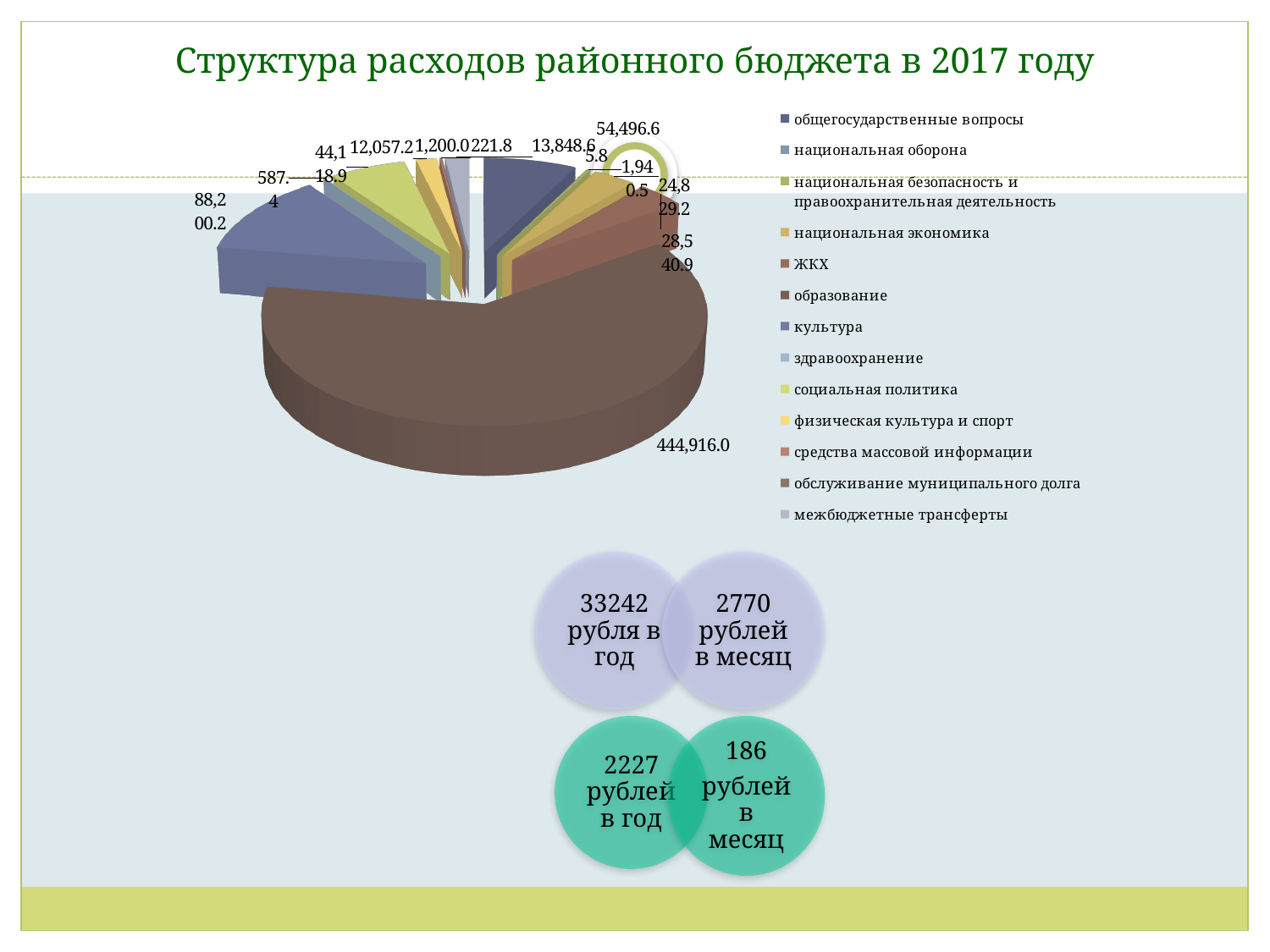
Which category has the largest slice of the pie? образование What value is labelled on the slice for культура? 88,200.2 What kind of chart is shown on the slide? pie chart What is the title of the chart? Структура расходов районного бюджета в 2017 году Which category is listed first in the chart's legend? общегосударственные вопросы What is the difference between the values labelled for образование (444,916.0) and культура (88,200.2)? 356,715.8 Is the value for образование greater or less than 400,000? greater What value is labelled on the largest slice of the pie (образование)? 444,916.0 Which slice is larger, образование or культура? образование How many categories does the chart's legend list? 13